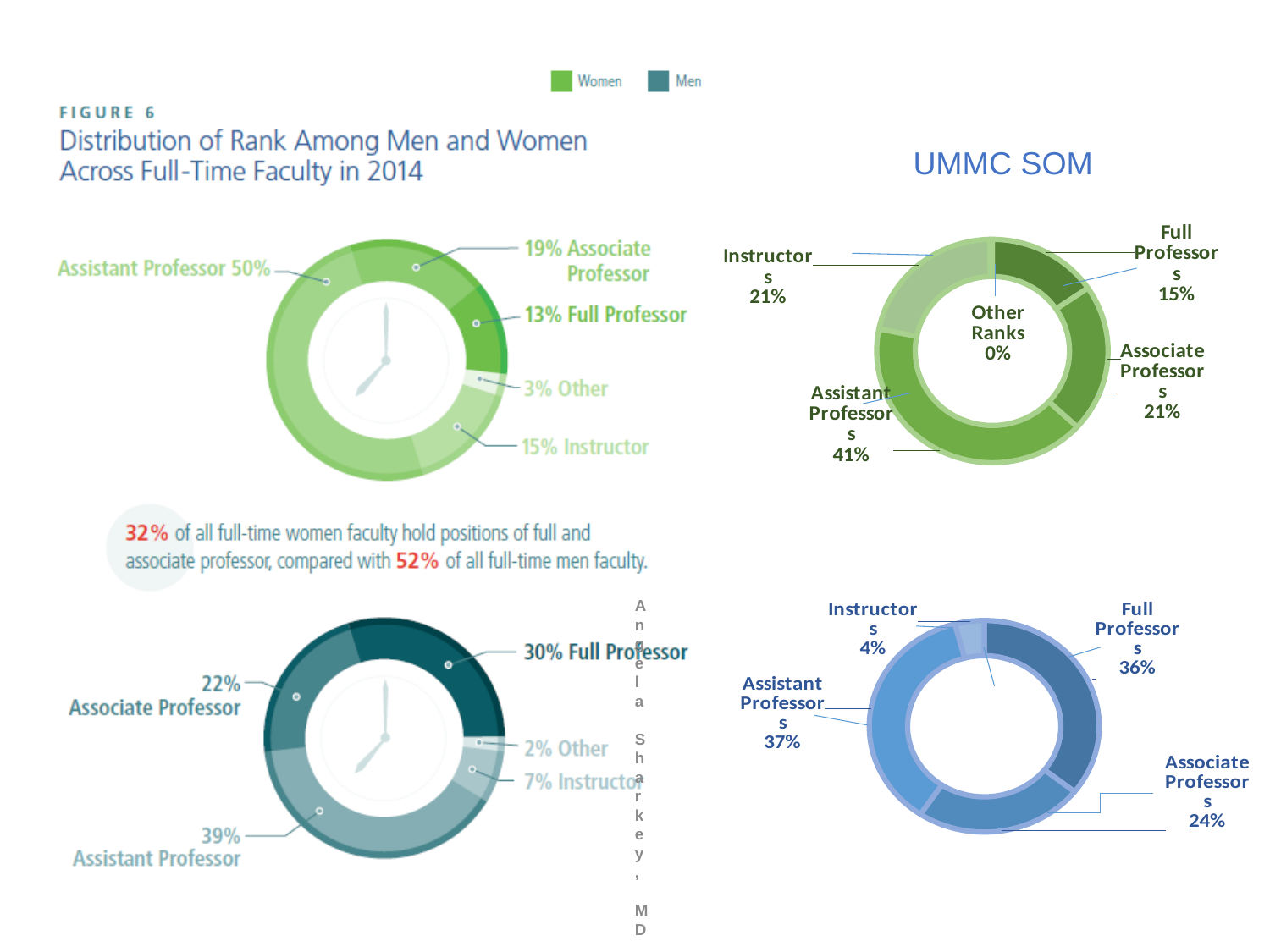
In the bottom-left donut chart (Figure 6, men), what is the difference between the Assistant Professor share and the Associate Professor share? 17% What type of chart is used for the UMMC SOM data on the right side of the slide? Donut (pie) chart In the bottom-left donut chart (Figure 6, men), which rank has the largest share? Assistant Professor In the top-right UMMC SOM donut chart (green), what percentage are Other Ranks? 0% In the bottom-right UMMC SOM donut chart (blue), what percentage are Instructors? 4% How many rank categories are labelled in the bottom-right UMMC SOM donut chart (blue)? 4 In the top-left donut chart (Figure 6, women), what percentage of faculty are Assistant Professors? 50% In the bottom-left donut chart (Figure 6, men), what percentage are Full Professors? 30% In the top-left donut chart (Figure 6, women), which rank has the smallest share? Other In the top-left donut chart (Figure 6, women), what percentage are Full Professors? 13% In the top-right UMMC SOM donut chart (green), what percentage are Assistant Professors? 41% In the bottom-right UMMC SOM donut chart (blue), which is larger, the Full Professors share or the Associate Professors share? Full Professors